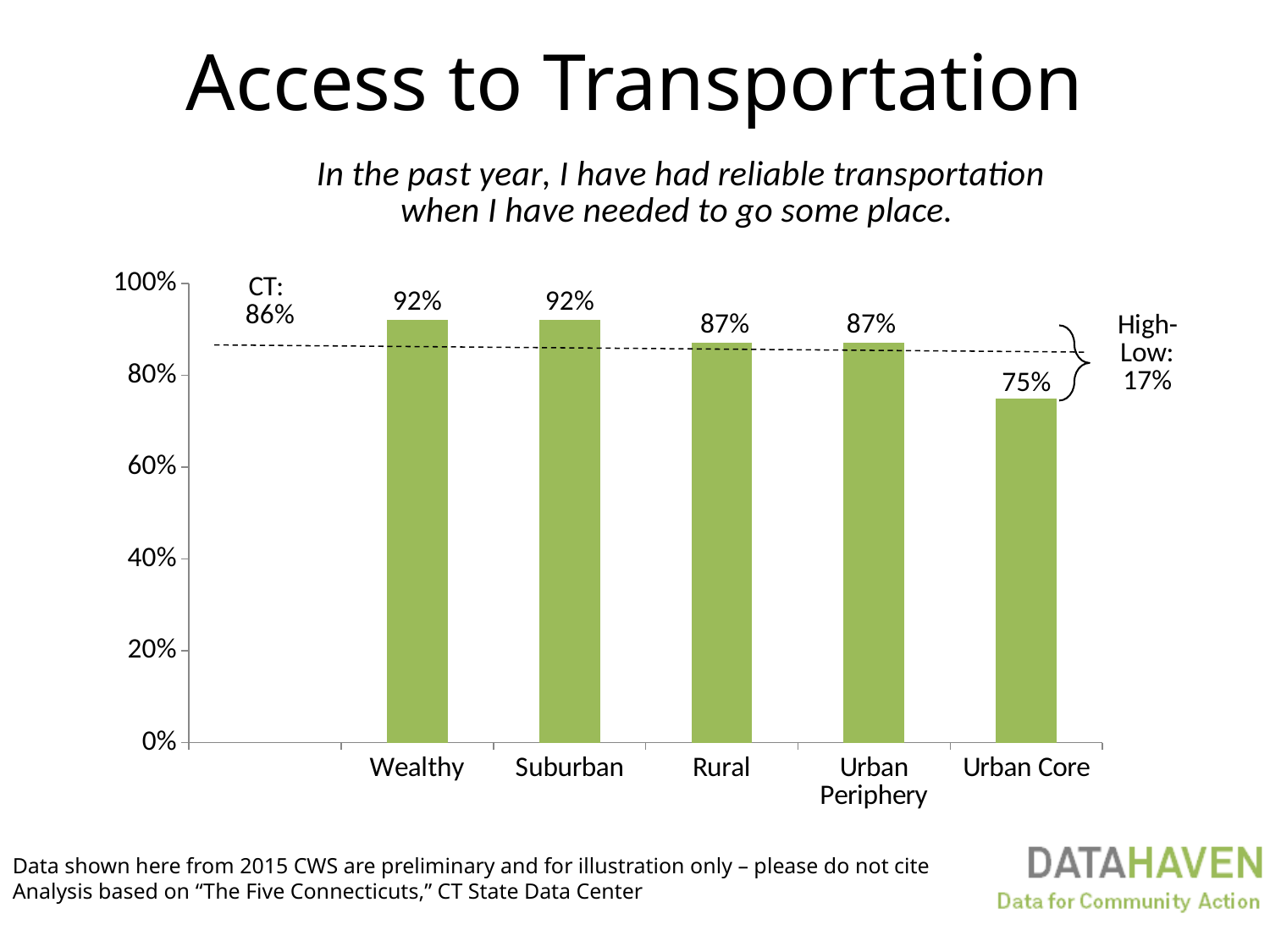
What is the difference between the values for Suburban and Urban Core? 17% Is the value for Urban Core greater or less than 80%? less What is the value for Rural? 87% How many categories are shown on the x axis? 5 Which category has the lowest value? Urban Core What is the value for Wealthy? 92% What is the value for Urban Core? 75% Which is larger, the value for Rural or the value for Urban Core? Rural What is the CT value marked by the dashed line? 86% What kind of chart is shown on the slide? bar chart What is the value for Urban Periphery? 87% What is the difference between the values for Wealthy and Rural? 5%